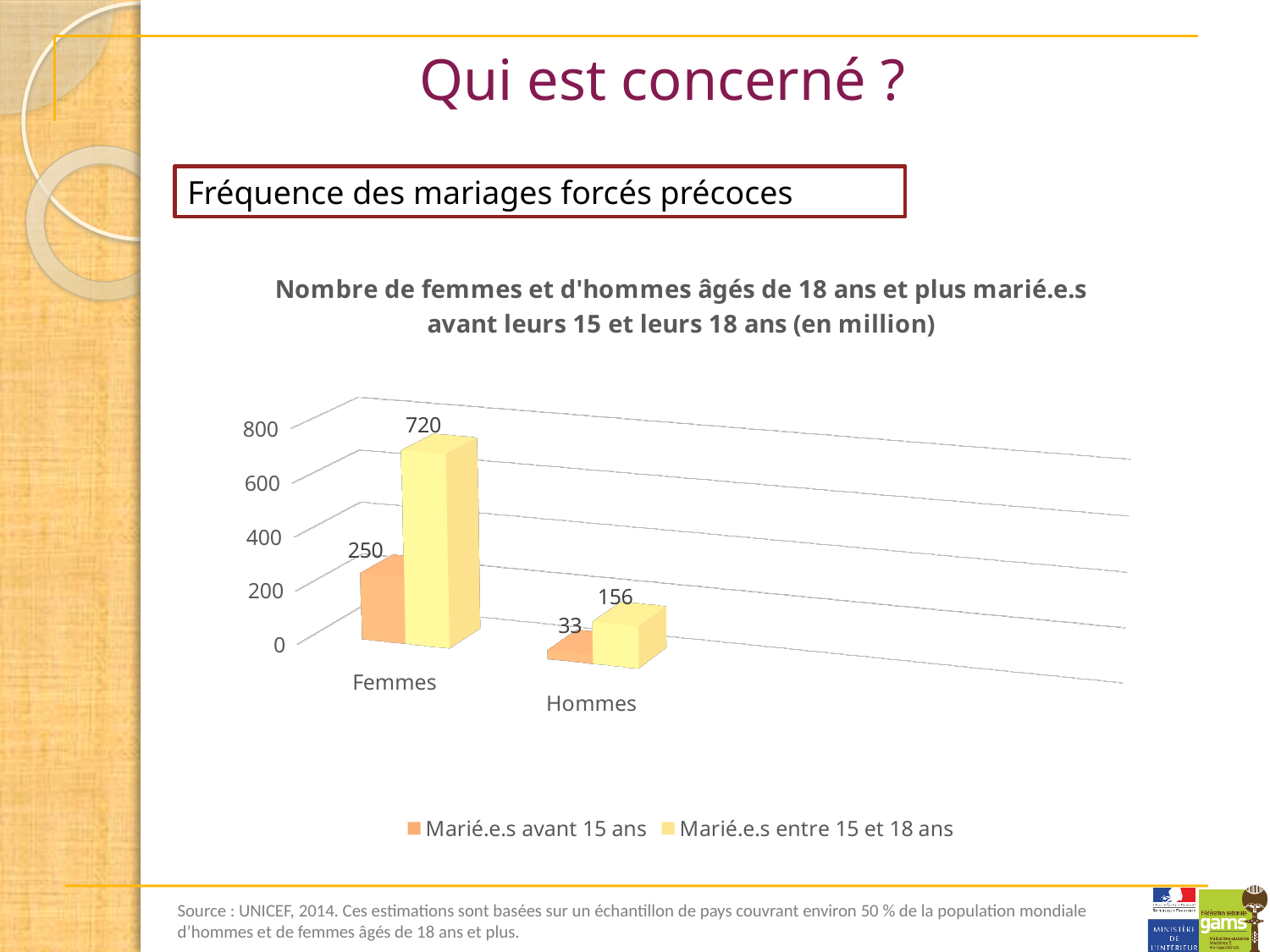
Which is larger: the 'Marié.e.s avant 15 ans' value for Femmes or the 'Marié.e.s entre 15 et 18 ans' value for Hommes? Marié.e.s avant 15 ans for Femmes How many series does the legend list? 2 What is the value for Hommes in the 'Marié.e.s entre 15 et 18 ans' series? 156 What kind of chart is shown on the slide? Bar chart How many categories are shown on the x axis? 2 Which category has the lowest value in the 'Marié.e.s avant 15 ans' series? Hommes What is the value for Femmes in the 'Marié.e.s entre 15 et 18 ans' series? 720 What is the value for Femmes in the 'Marié.e.s avant 15 ans' series? 250 Which category has the highest value in the 'Marié.e.s entre 15 et 18 ans' series? Femmes What is the difference between the two series values for Femmes? 470 What is the difference between the 'Marié.e.s entre 15 et 18 ans' values for Femmes and Hommes? 564 What is the value for Hommes in the 'Marié.e.s avant 15 ans' series? 33